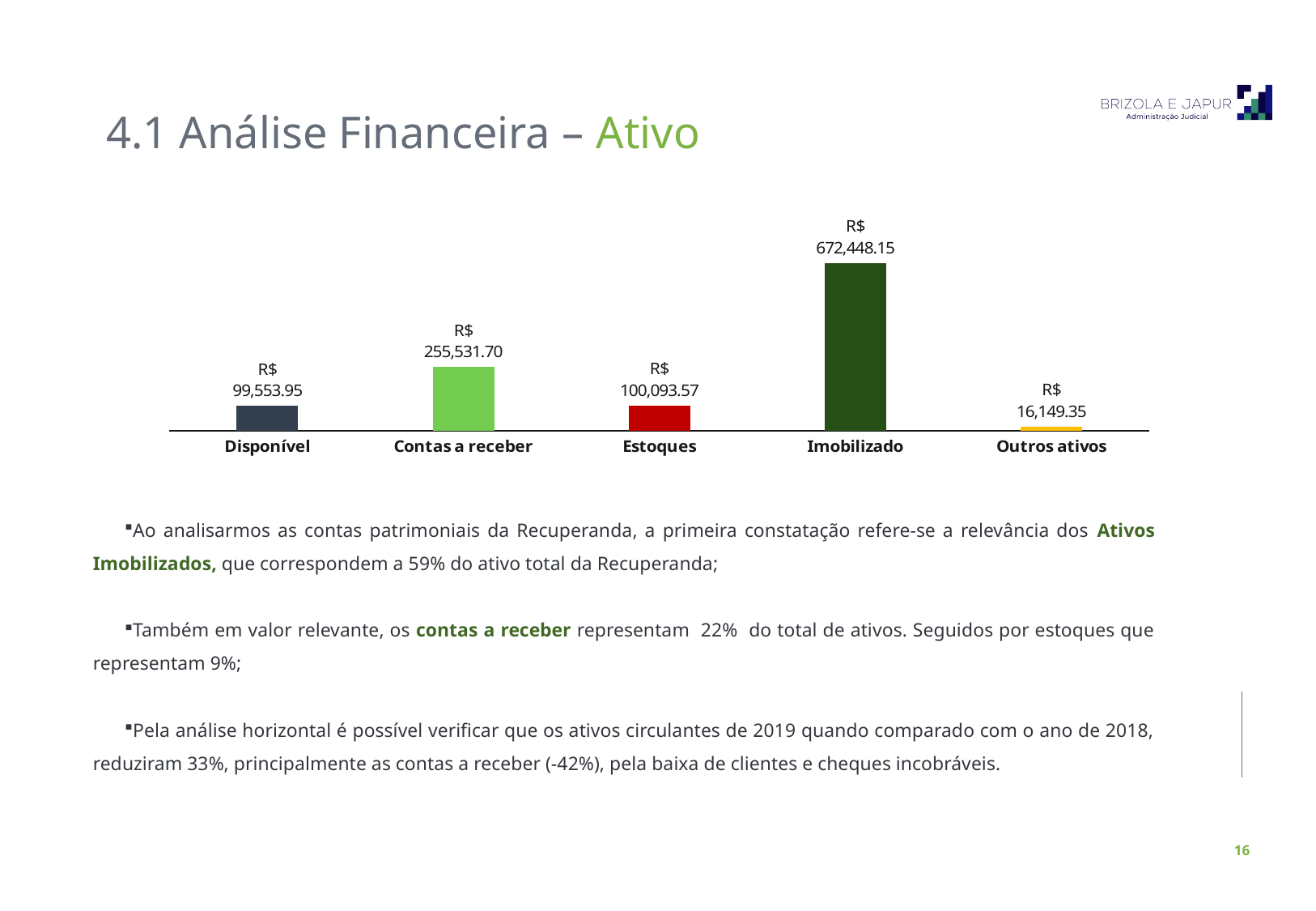
What is the value shown for Outros ativos? R$ 16,149.35 What is the value shown for Disponível? R$ 99,553.95 What is the value shown for Imobilizado? R$ 672,448.15 Which category has the lowest value? Outros ativos What is the value shown for Estoques? R$ 100,093.57 What type of chart is shown on the slide? Bar chart How many categories are shown in the chart? 5 What is the value shown for Contas a receber? R$ 255,531.70 What is the difference between the values for Imobilizado and Contas a receber? R$ 416,916.45 Which category has the highest value? Imobilizado Which is larger, the value for Contas a receber or the value for Disponível? Contas a receber What is the difference between the values for Contas a receber and Estoques? R$ 155,438.13